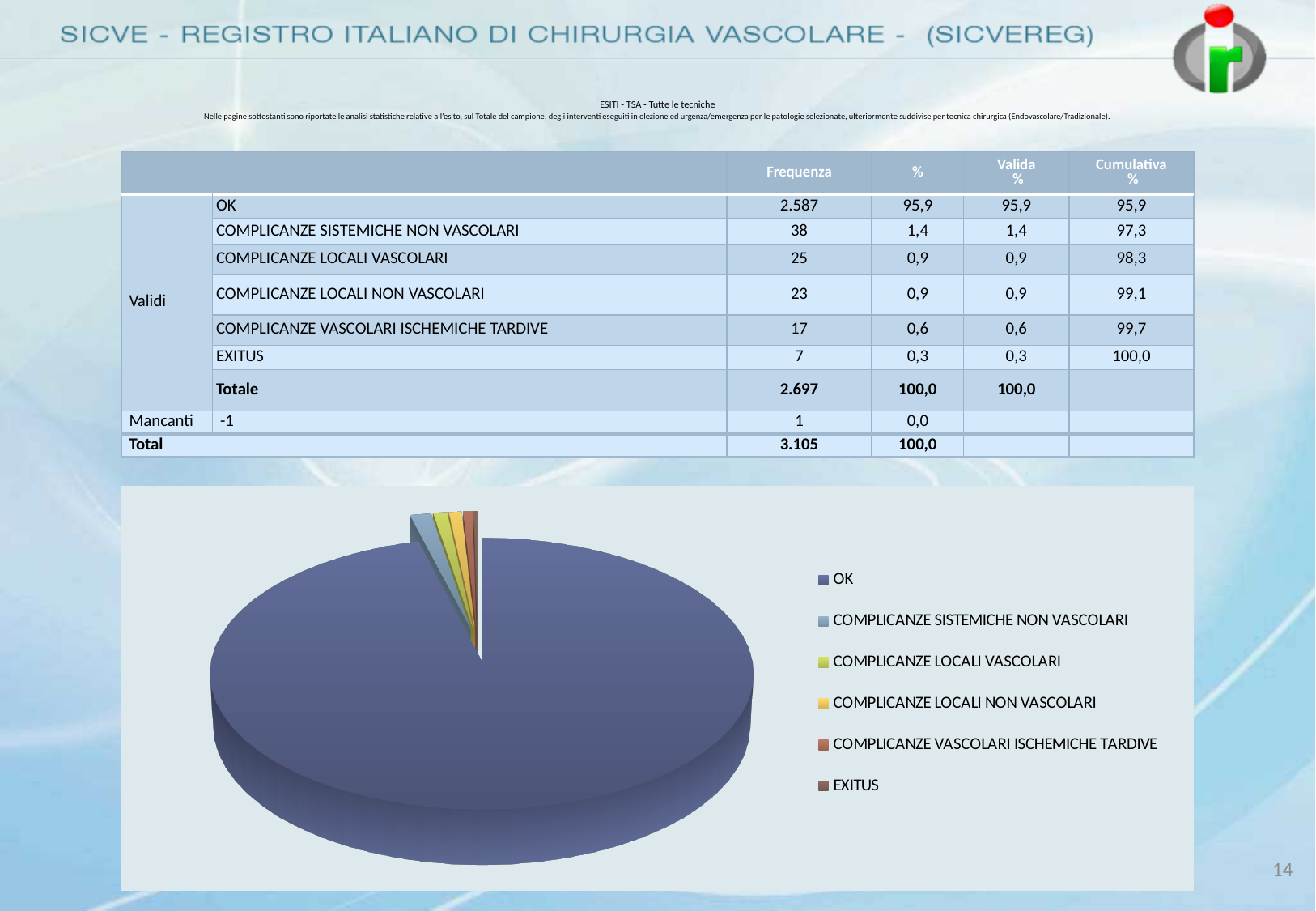
How many categories does the pie chart's legend list? 6 Which category has the smallest slice in the pie chart? EXITUS Is the slice for OK larger or smaller than the slice for EXITUS? larger According to the table, what is the Frequenza for OK? 2.587 According to the table, what is the Frequenza for COMPLICANZE VASCOLARI ISCHEMICHE TARDIVE? 17 What share of the pie does the OK slice represent, according to the Valida % column? 95,9 What is the difference in Frequenza between COMPLICANZE LOCALI VASCOLARI and COMPLICANZE LOCALI NON VASCOLARI? 2 Which legend entry is listed first in the pie chart's legend? OK Which category has the largest slice in the pie chart? OK What kind of chart is shown on the slide? pie chart According to the table, what is the Valida % for COMPLICANZE SISTEMICHE NON VASCOLARI? 1,4 According to the table, what is the Frequenza for EXITUS? 7